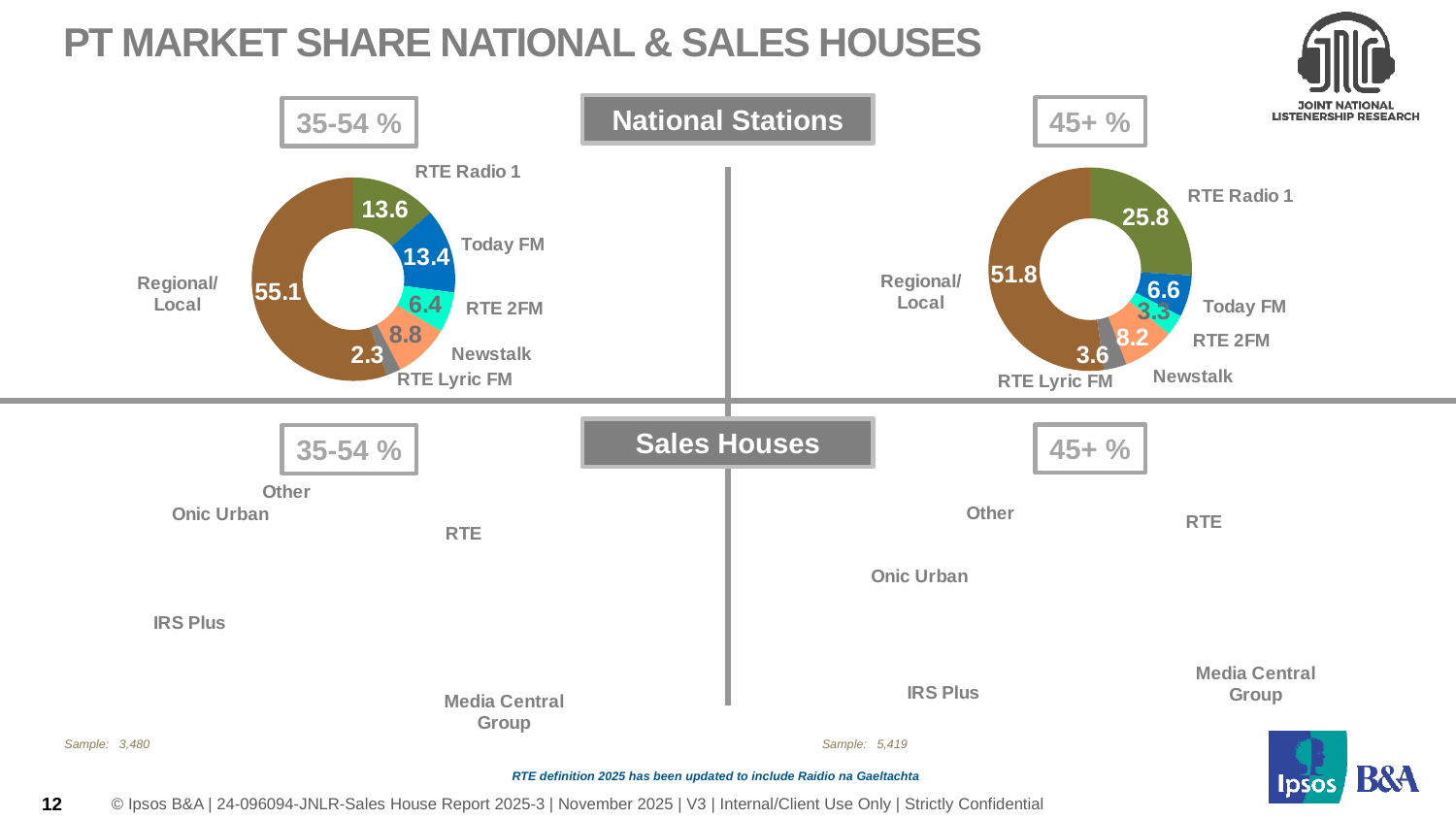
In the National Stations 45+ chart, which category has the largest share? Regional/Local In the National Stations 35-54 chart, which is larger: the value for Newstalk or the value for RTE 2FM? Newstalk In the National Stations 35-54 chart, what is the value for Regional/Local? 55.1 In the National Stations 45+ chart, what is the value for RTE Radio 1? 25.8 In the National Stations 35-54 chart, what is the value for Newstalk? 8.8 What type of chart is used for the National Stations 45+ data? Donut (pie) chart In the National Stations 45+ chart, which is larger: the value for Newstalk or the value for Today FM? Newstalk In the National Stations 35-54 chart, what is the difference between the values for RTE Radio 1 and RTE 2FM? 7.2 In the National Stations 45+ chart, what is the value for Today FM? 6.6 How many categories are shown in the National Stations 35-54 chart? 6 In the National Stations 45+ chart, what is the difference between the values for Regional/Local and RTE Radio 1? 26.0 In the National Stations 35-54 chart, which station has the smallest share? RTE Lyric FM